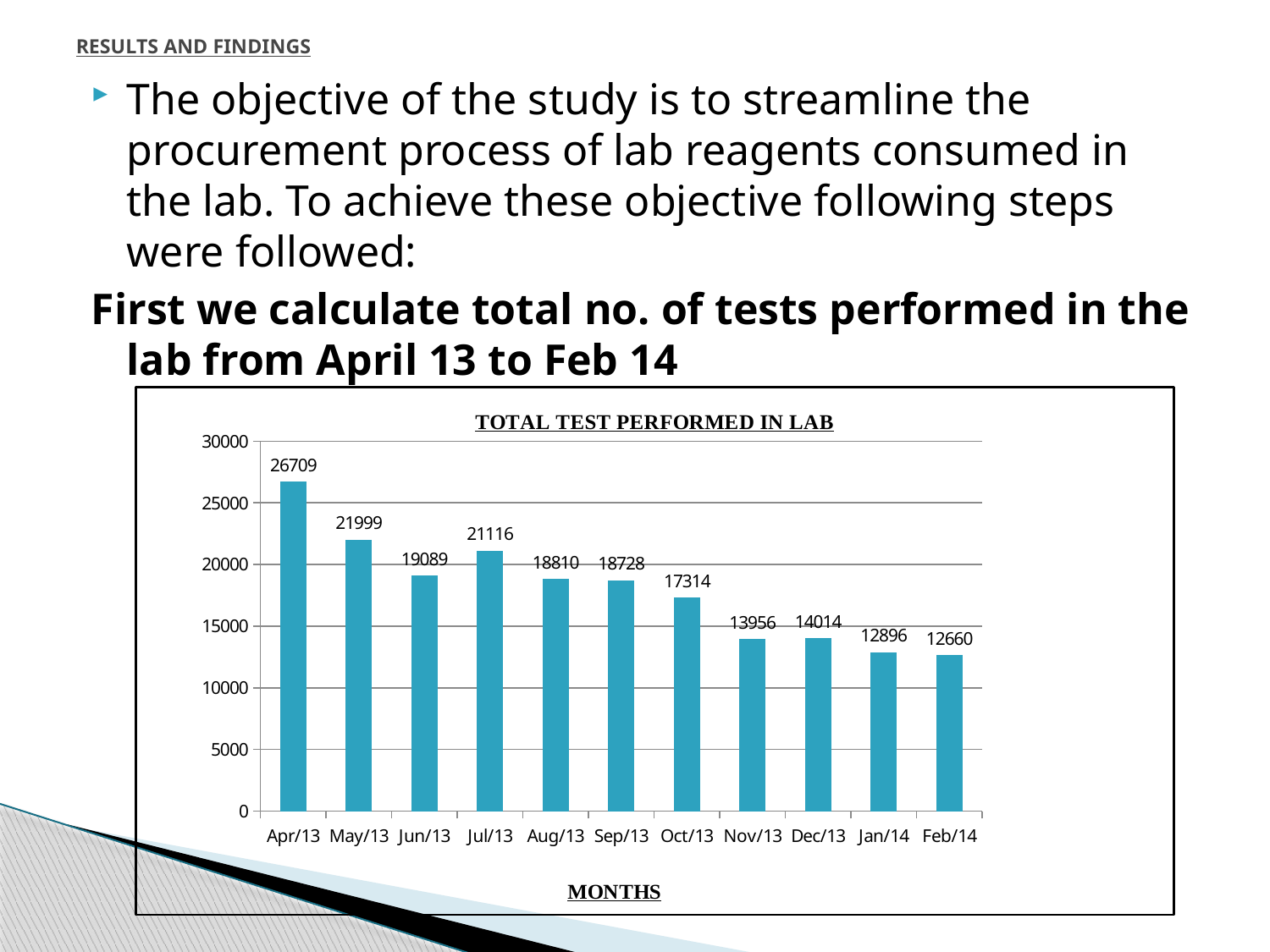
What kind of chart is shown on the slide? bar chart What is the value for Apr/13 in the chart? 26709 What is the value for Oct/13 in the chart? 17314 What is the title of the chart? TOTAL TEST PERFORMED IN LAB Which month has the highest number of tests performed? Apr/13 Which month has the lowest number of tests performed? Feb/14 How many months are shown on the x axis of the chart? 11 Which is larger, the value for May/13 or the value for Jul/13? May/13 What is the difference between the values for Jul/13 and Aug/13? 2306 Is the value for Jun/13 greater or less than 20000? less What is the difference between the values for Apr/13 and May/13? 4710 What is the value for Feb/14 in the chart? 12660